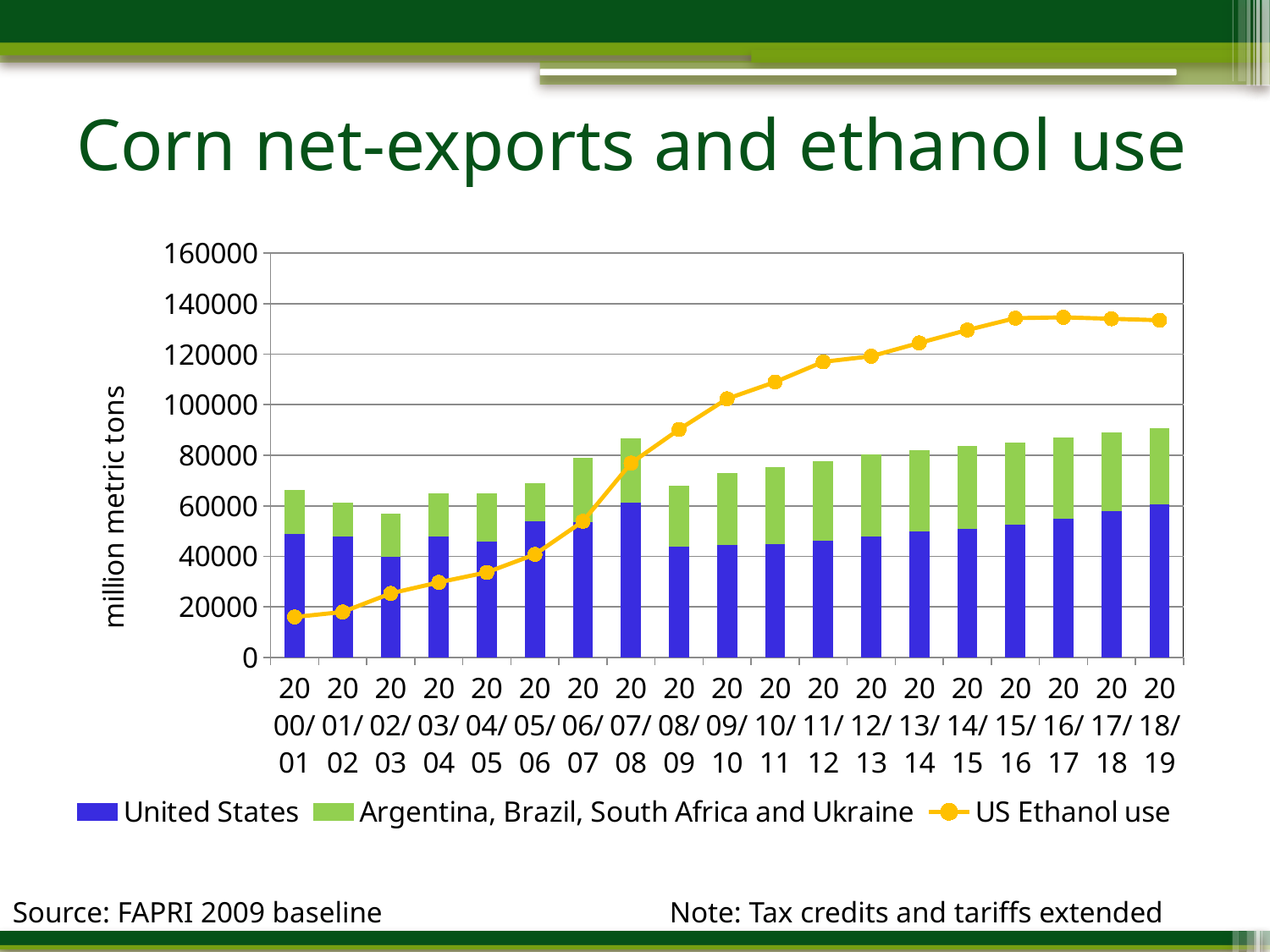
What kind of chart is this? Stacked bar chart with a line Is the total height of the stacked bar for 2007/08 greater or less than 80000? greater Is the value for US Ethanol use in 2018/19 greater or less than 120000? greater How many marketing years are shown along the x axis? 19 What is the label on the vertical axis of the chart? million metric tons Is the value for US Ethanol use in 2000/01 greater or less than 20000? less In 2018/19, which is larger: US Ethanol use or the total stacked net-export bar? US Ethanol use What is the title of the chart? Corn net-exports and ethanol use Does US Ethanol use generally rise or fall from 2000/01 to 2018/19? Rise In which year is US Ethanol use lowest? 2000/01 How many series does the legend list? 3 In which year is the United States net-export bar lowest? 2002/03